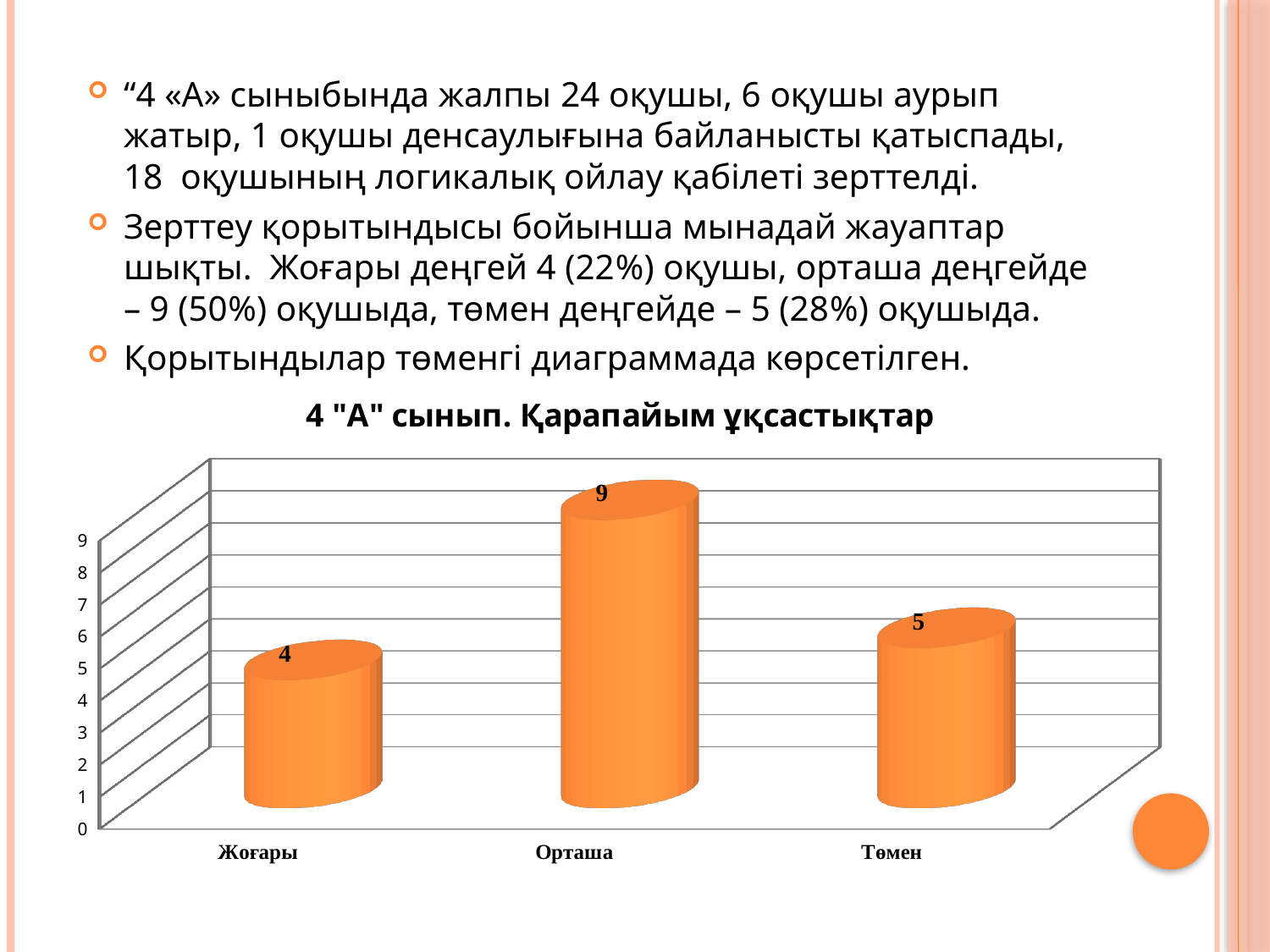
What is the value for Төмен? 5 What is the difference between the values for Орташа and Төмен? 4 Which category has the highest value? Орташа What is the value for Жоғары? 4 How many categories are shown on the x axis? 3 Which is larger, the value for Жоғары or the value for Төмен? Төмен What is the value for Орташа? 9 What is the difference between the values for Төмен and Жоғары? 1 What is the title of the chart? 4 "А" сынып. Қарапайым ұқсастықтар What is the total of the three values shown in the chart? 18 Which category has the lowest value? Жоғары What kind of chart is shown on the slide? bar chart